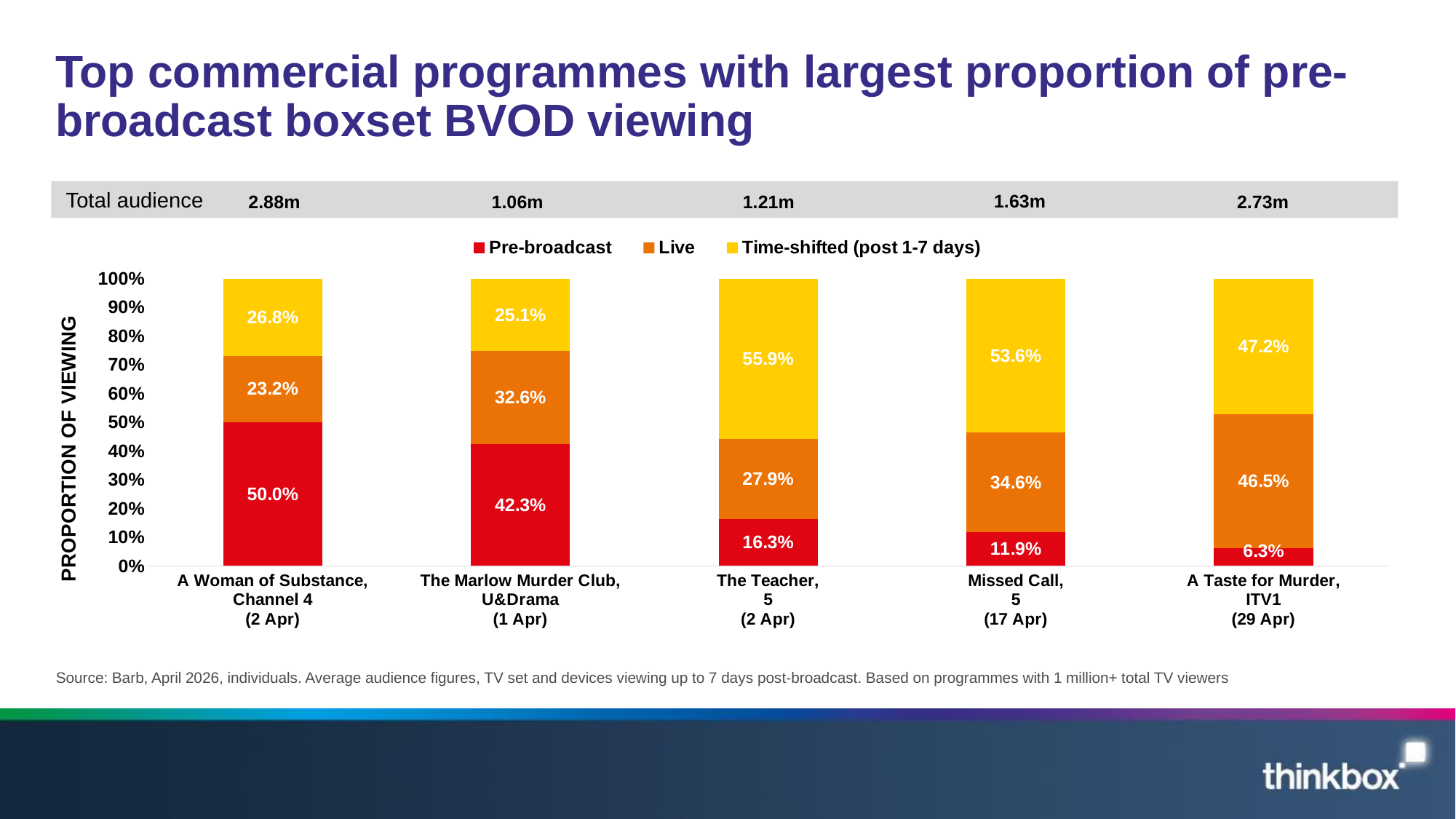
Which programme has the highest Pre-broadcast share? A Woman of Substance What kind of chart is shown on the slide? Stacked bar chart What is the Time-shifted (post 1-7 days) share for The Teacher? 55.9% What is the total audience shown for The Teacher? 1.21m What is the Pre-broadcast share for A Woman of Substance? 50.0% Which programme has the lowest Pre-broadcast share? A Taste for Murder How many programmes are shown on the chart? 5 What is the Live share for A Taste for Murder? 46.5% What is the difference between the Live shares of Missed Call and The Teacher? 6.7% How many series does the legend list? 3 Which is larger: the Time-shifted share for The Marlow Murder Club or for Missed Call? Missed Call Is the Pre-broadcast share for The Marlow Murder Club greater or less than 40%? greater